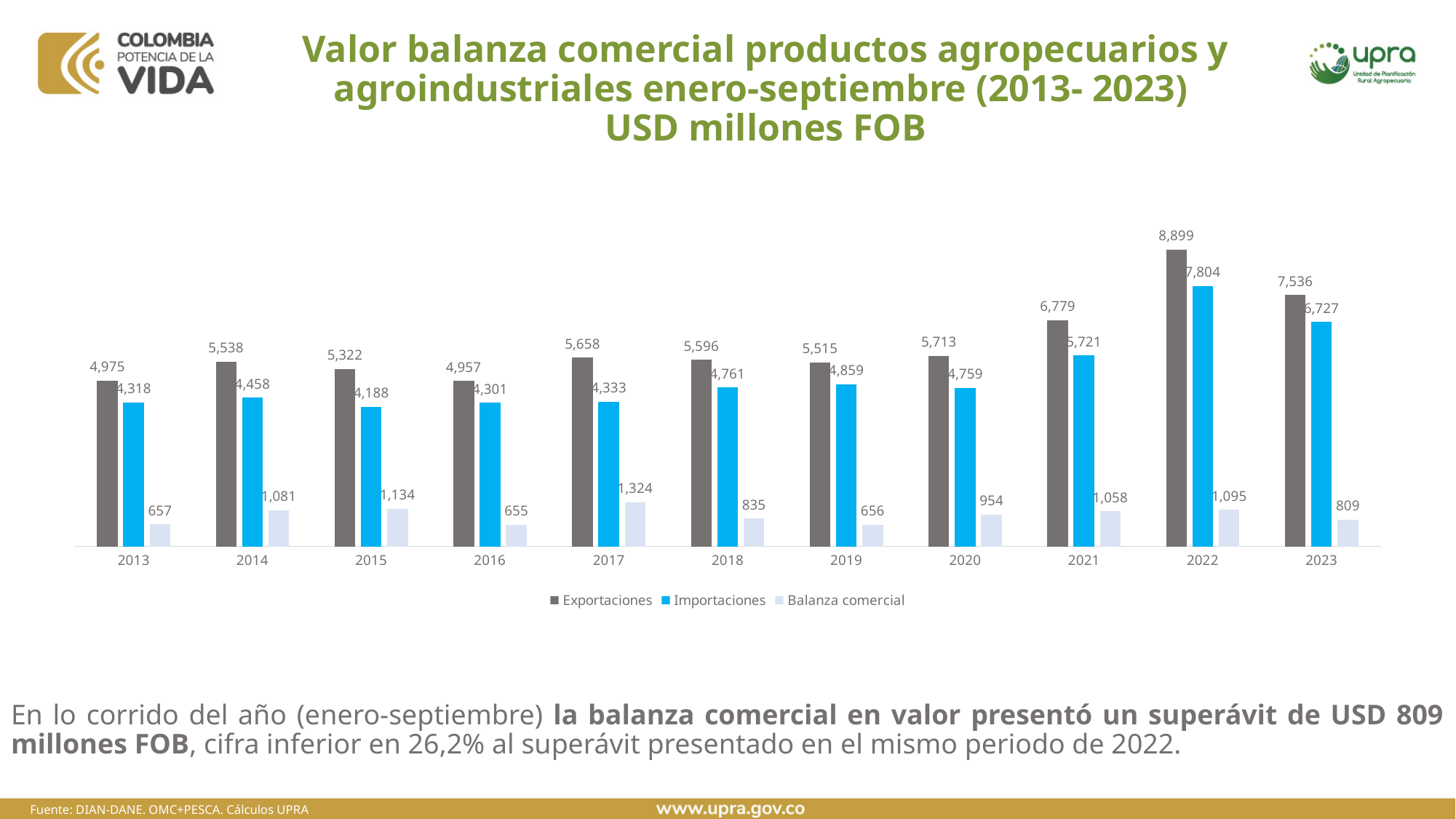
Which year has the lowest Balanza comercial value? 2016 What kind of chart is shown on the slide? Bar chart What is the value of Importaciones in 2013? 4,318 How many series does the legend list? 3 What is the difference between Exportaciones and Importaciones in 2023? 809 How many years are shown on the x axis? 11 What is the Balanza comercial value for 2017? 1,324 Which series is shown in blue in the legend? Importaciones Which year has the highest Exportaciones value? 2022 Did Exportaciones rise or fall from 2022 to 2023? Fall What is the value of Exportaciones in 2022? 8,899 Which is larger: Importaciones in 2021 or Importaciones in 2023? Importaciones in 2023